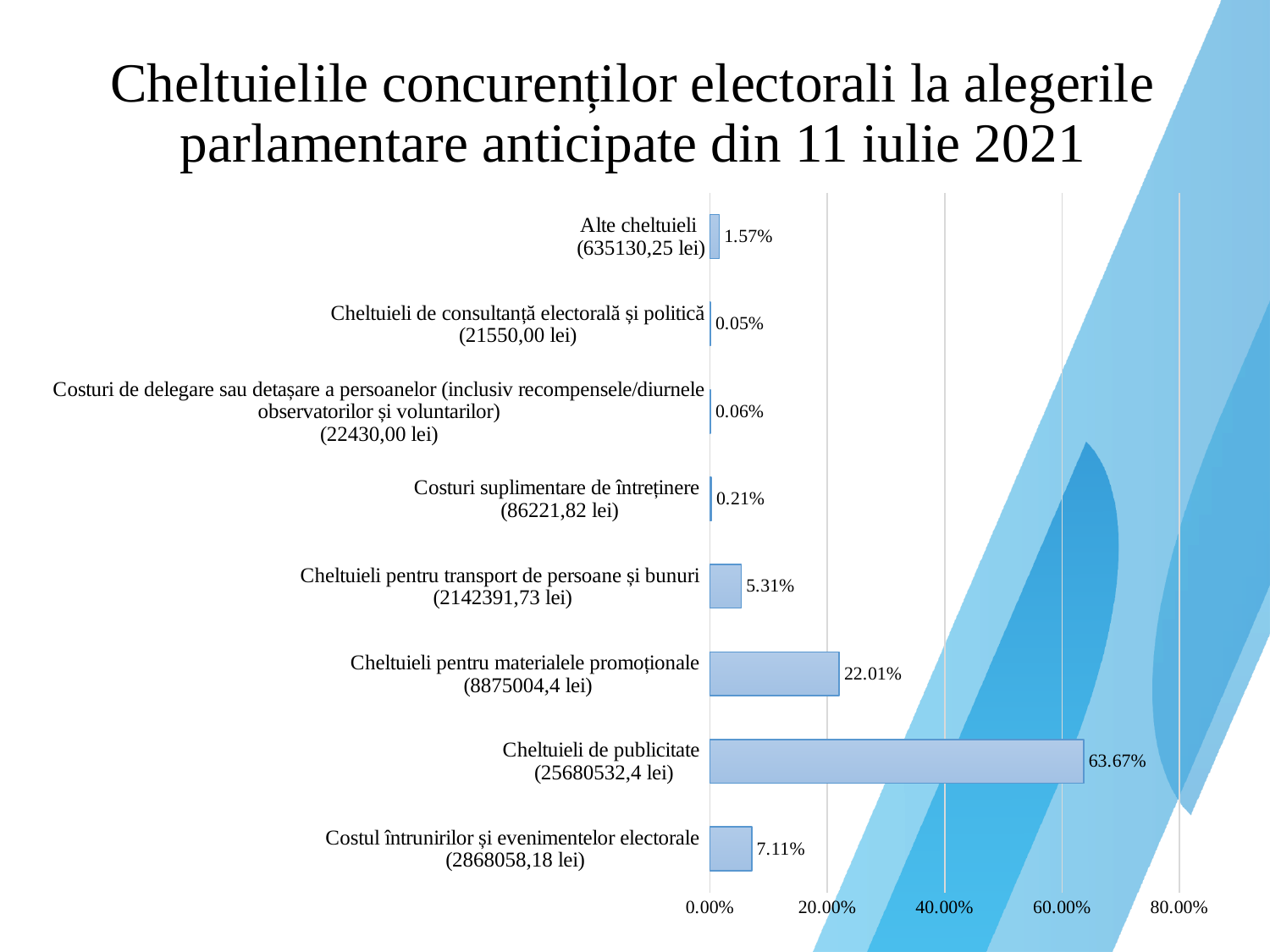
Which category has the highest value? Cheltuieli de publicitate What is the value for Cheltuieli pentru materialele promoționale? 22.01% What type of chart is shown on the slide? bar chart What is the difference between the values for Cheltuieli de publicitate and Cheltuieli pentru materialele promoționale? 41.66% How many categories are shown in the chart? 8 What is the value for Cheltuieli pentru transport de persoane și bunuri? 5.31% What is the value for Costul întrunirilor și evenimentelor electorale? 7.11% What is the value for Alte cheltuieli? 1.57% Which category has the lowest value? Cheltuieli de consultanță electorală și politică Which is larger, the value for Costul întrunirilor și evenimentelor electorale or the value for Cheltuieli pentru transport de persoane și bunuri? Costul întrunirilor și evenimentelor electorale What is the value for Cheltuieli de publicitate? 63.67% Is the value for Cheltuieli de publicitate greater or less than 60.00%? greater